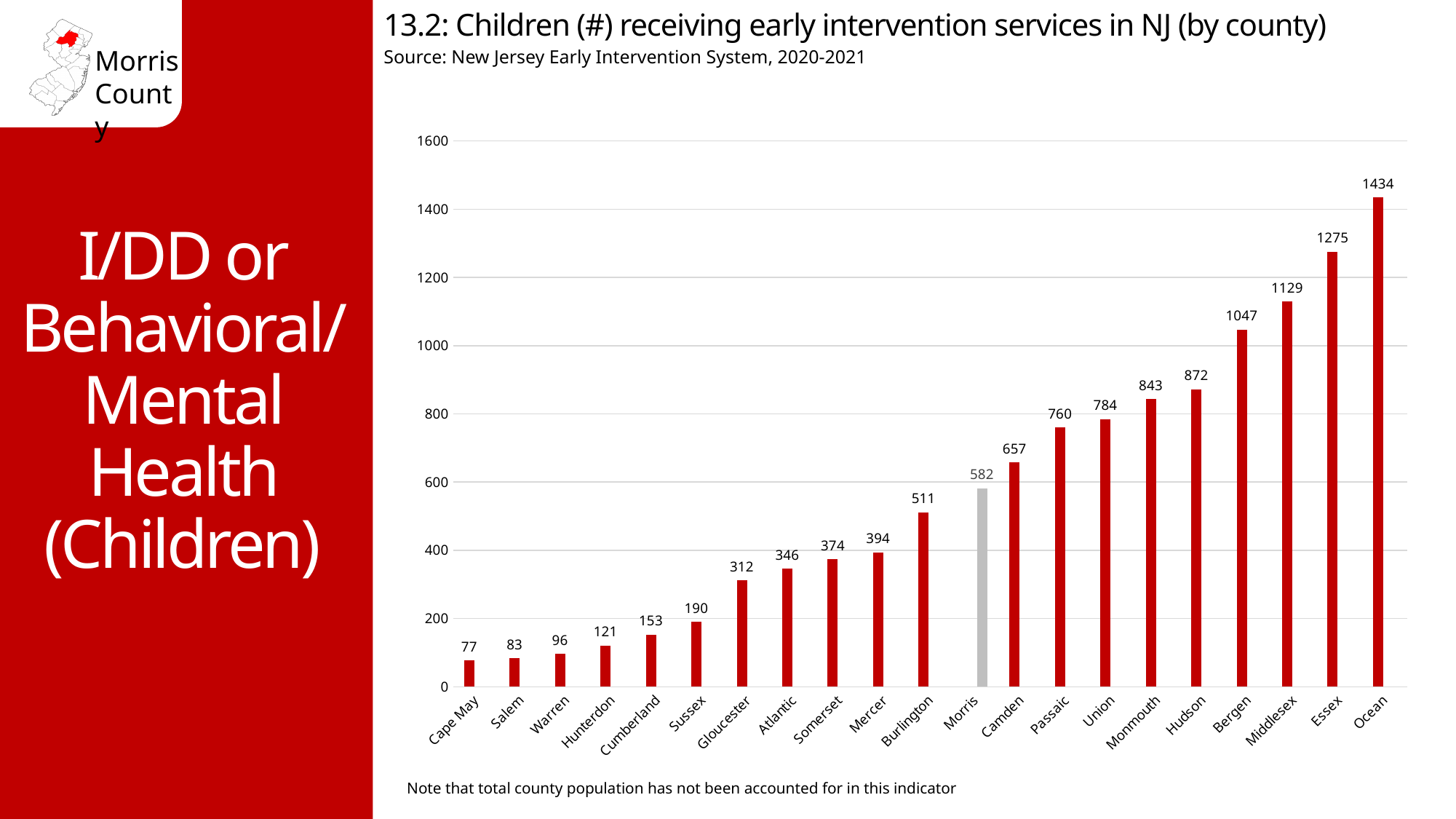
What is the difference between the values for Morris and Burlington? 71 Which county's bar is shown in grey rather than red? Morris Which county has the lowest number of children receiving early intervention services? Cape May Which county has the highest number of children receiving early intervention services? Ocean How many counties are shown on the chart? 21 Is the value for Camden greater or less than 600? greater Which county has a larger value, Passaic or Union? Union What is the value shown for Bergen County? 1047 How many children received early intervention services in Morris County? 582 What kind of chart is shown on the slide? Bar chart What is the difference between the values for Ocean and Essex? 159 Do the values rise or fall moving from left to right along the x axis? Rise